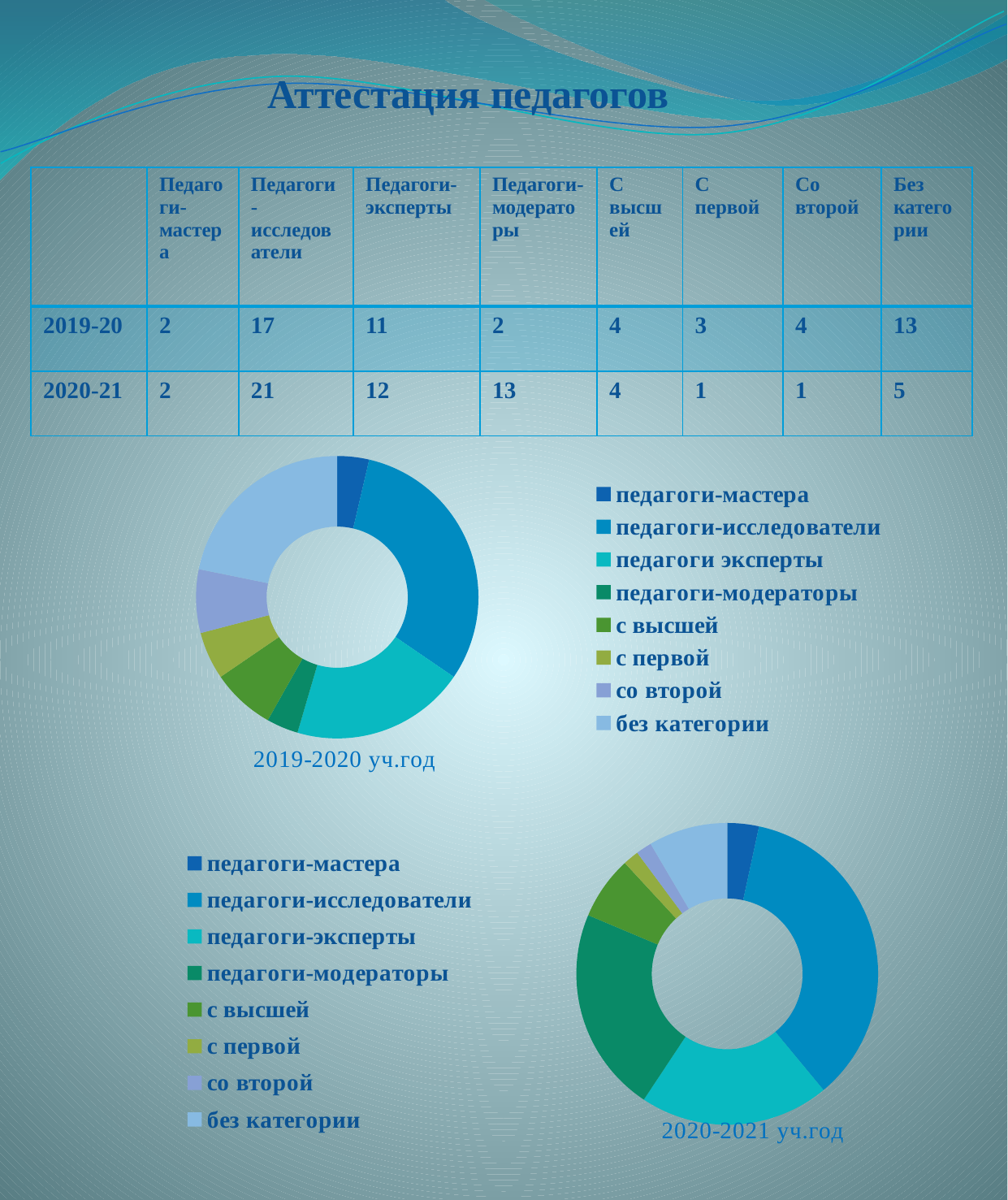
How many categories does the legend of the 2020-2021 уч.год chart list? 8 In the 2019-2020 уч.год chart, which category has the largest slice? педагоги-исследователи In the 2020-2021 уч.год chart, what is the value for педагоги-модераторы? 13 What is the title of the slide containing the two doughnut charts? Аттестация педагогов In the 2020-2021 уч.год chart, which category has the largest slice? педагоги-исследователи What kind of chart is the 2019-2020 уч.год chart? doughnut chart In the 2019-2020 уч.год chart, what is the value for педагоги-исследователи? 17 In the 2020-2021 уч.год chart, what is the difference between педагоги-исследователи and без категории? 16 In the 2020-2021 уч.год chart, which is larger: педагоги-исследователи or без категории? педагоги-исследователи How many slices does the 2019-2020 уч.год chart have? 8